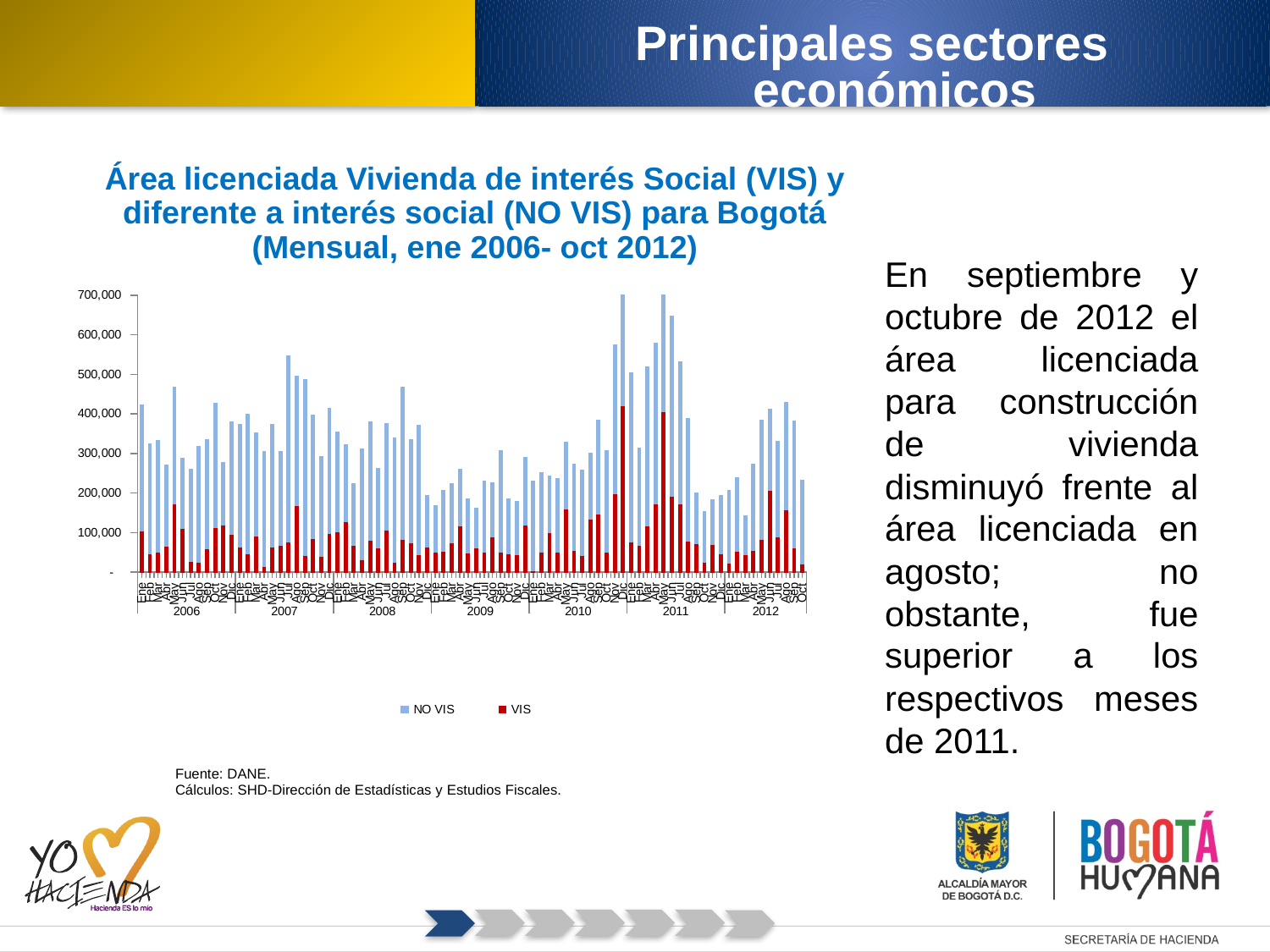
How many years are labeled along the x axis of the chart? 7 Which series is drawn in red in the chart? VIS Which series, NO VIS or VIS, makes up the larger part of the bars in most months? NO VIS Is the total of the first bar shown (Ene 2006) greater or less than 300,000? greater Is the total licensed area for the last bar shown (Oct 2012) greater or less than 300,000? less What kind of chart is shown on the slide? Stacked bar chart Is the total of the tallest bar in the chart greater or less than 600,000? greater How many series does the chart's legend list? 2 What are the two series listed in the chart's legend? NO VIS and VIS